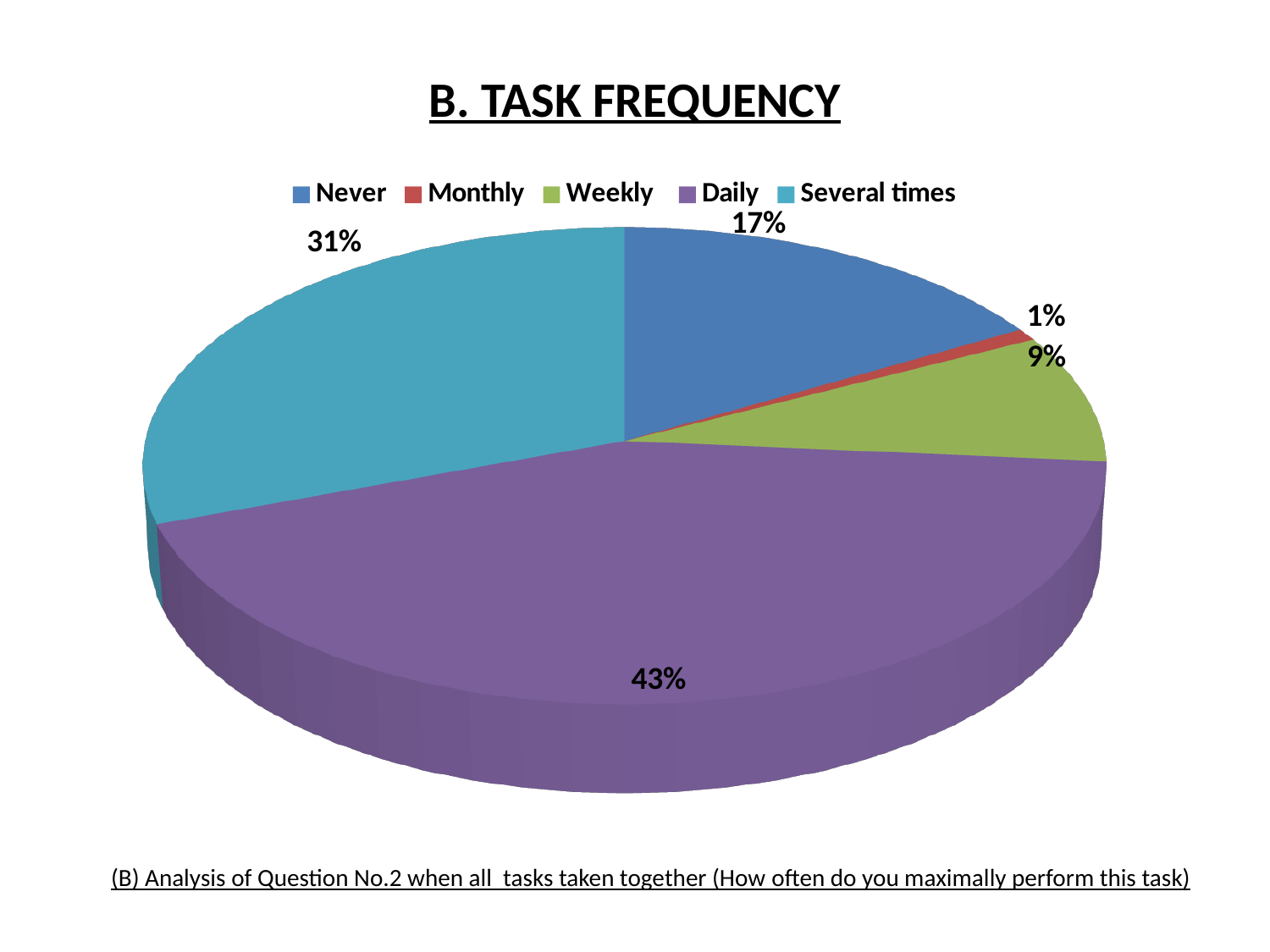
What is the difference in percentage points between Daily and Several times? 12 What percentage of the pie is labelled for Several times? 31% What percentage of the pie is labelled for Weekly? 9% What percentage of the pie is labelled for Never? 17% What is the title of the chart? B. TASK FREQUENCY Which is larger, the share for Never or the share for Weekly? Never What percentage of the pie is labelled for Daily? 43% What percentage of the pie is labelled for Monthly? 1% What kind of chart is shown on the slide? pie chart How many categories does the legend list? 5 Which category has the smallest share of the pie? Monthly Which category has the largest share of the pie? Daily